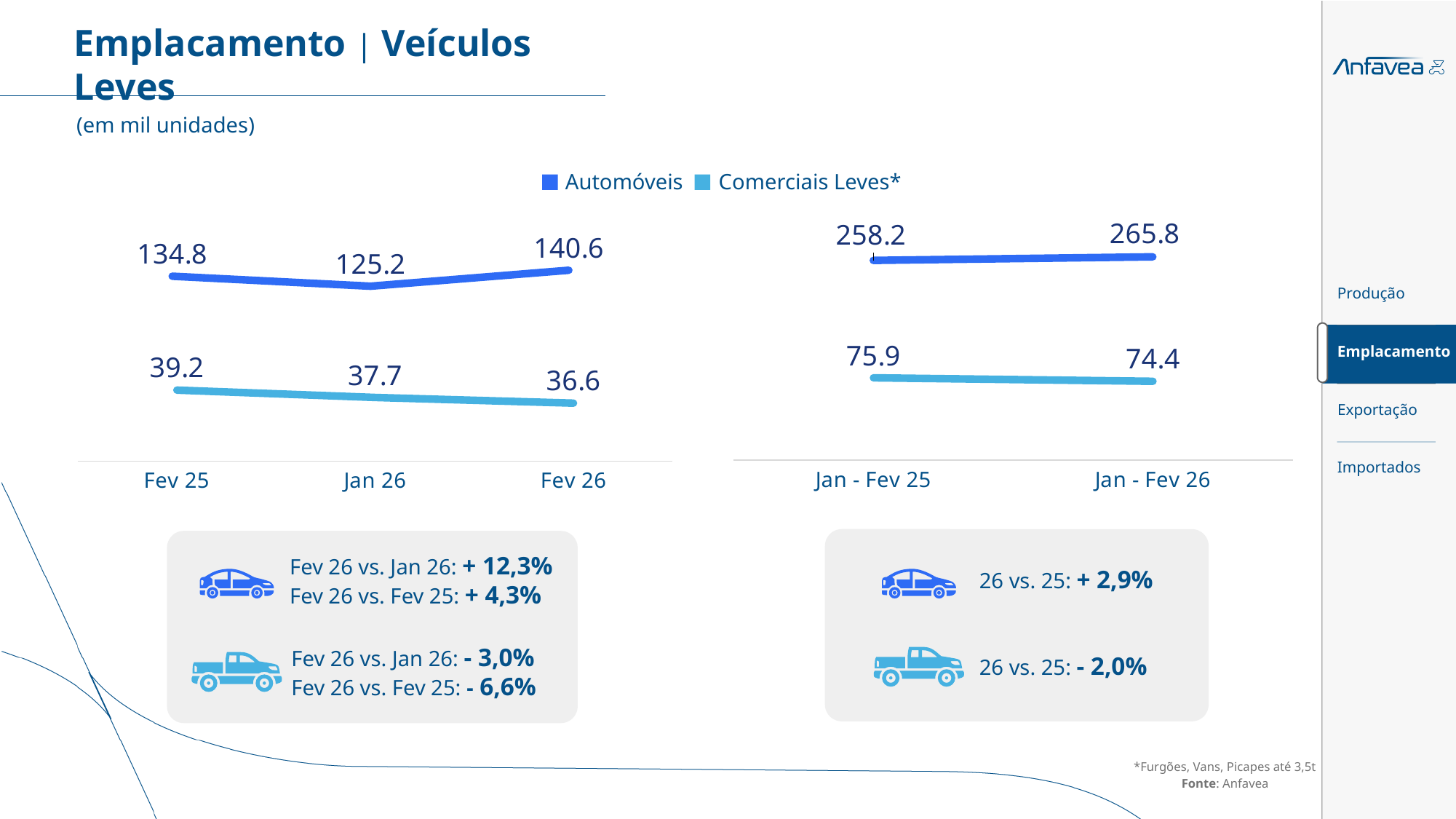
In the right chart, what is the value for Comerciais Leves* in Jan - Fev 25? 75.9 In the left chart, what is the value for Automóveis in Fev 26? 140.6 In the left chart, what is the difference between the Automóveis values for Fev 26 and Jan 26? 15.4 In the right chart, is the Comerciais Leves* value larger in Jan - Fev 25 or Jan - Fev 26? Jan - Fev 25 How many periods are shown on the x axis of the left chart? 3 In the right chart, what is the value for Automóveis in Jan - Fev 26? 265.8 In the left chart, do the Comerciais Leves* values rise or fall from Fev 25 to Fev 26? fall In the left chart, what is the value for Comerciais Leves* in Jan 26? 37.7 In the left chart, which period has the lowest value for Automóveis? Jan 26 In the right chart, what is the difference between the Automóveis values for Jan - Fev 26 and Jan - Fev 25? 7.6 How many series does the legend list? 2 In the left chart, which period has the highest value for Comerciais Leves*? Fev 25